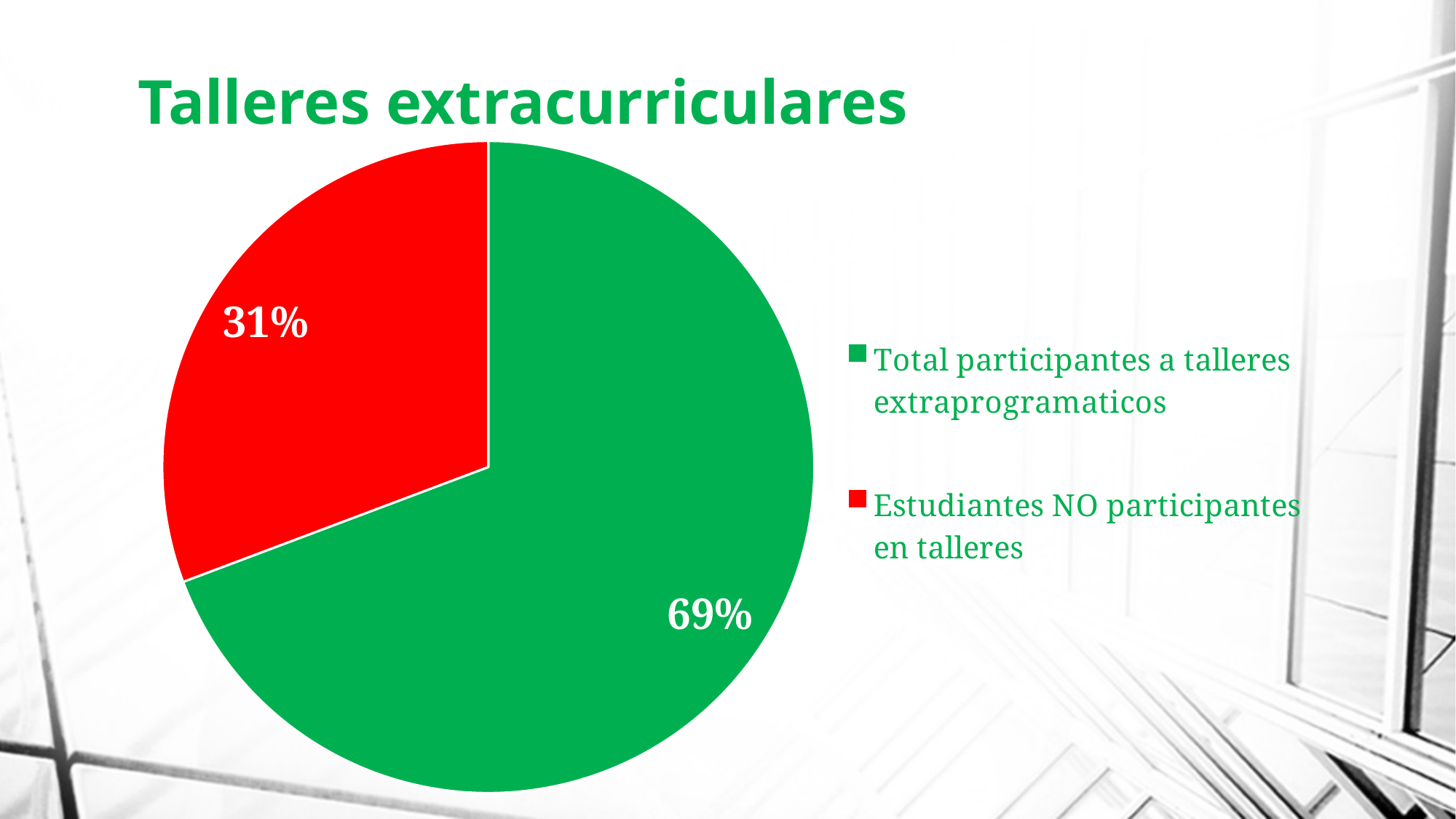
What is the title of the slide? Talleres extracurriculares What is the difference in percentage points between the two slices? 38 What colour is the slice for "Estudiantes NO participantes en talleres"? Red How many slices does the pie chart have? 2 What share of the pie does the green slice represent? 69% Which category has the smallest slice of the pie? Estudiantes NO participantes en talleres What percentage is shown for "Estudiantes NO participantes en talleres"? 31% Which category has the largest slice of the pie? Total participantes a talleres extraprogramaticos Which is larger: the share for "Total participantes a talleres extraprogramaticos" or for "Estudiantes NO participantes en talleres"? Total participantes a talleres extraprogramaticos How many entries does the legend list? 2 What percentage is shown for "Total participantes a talleres extraprogramaticos"? 69% What kind of chart is shown on the slide? Pie chart